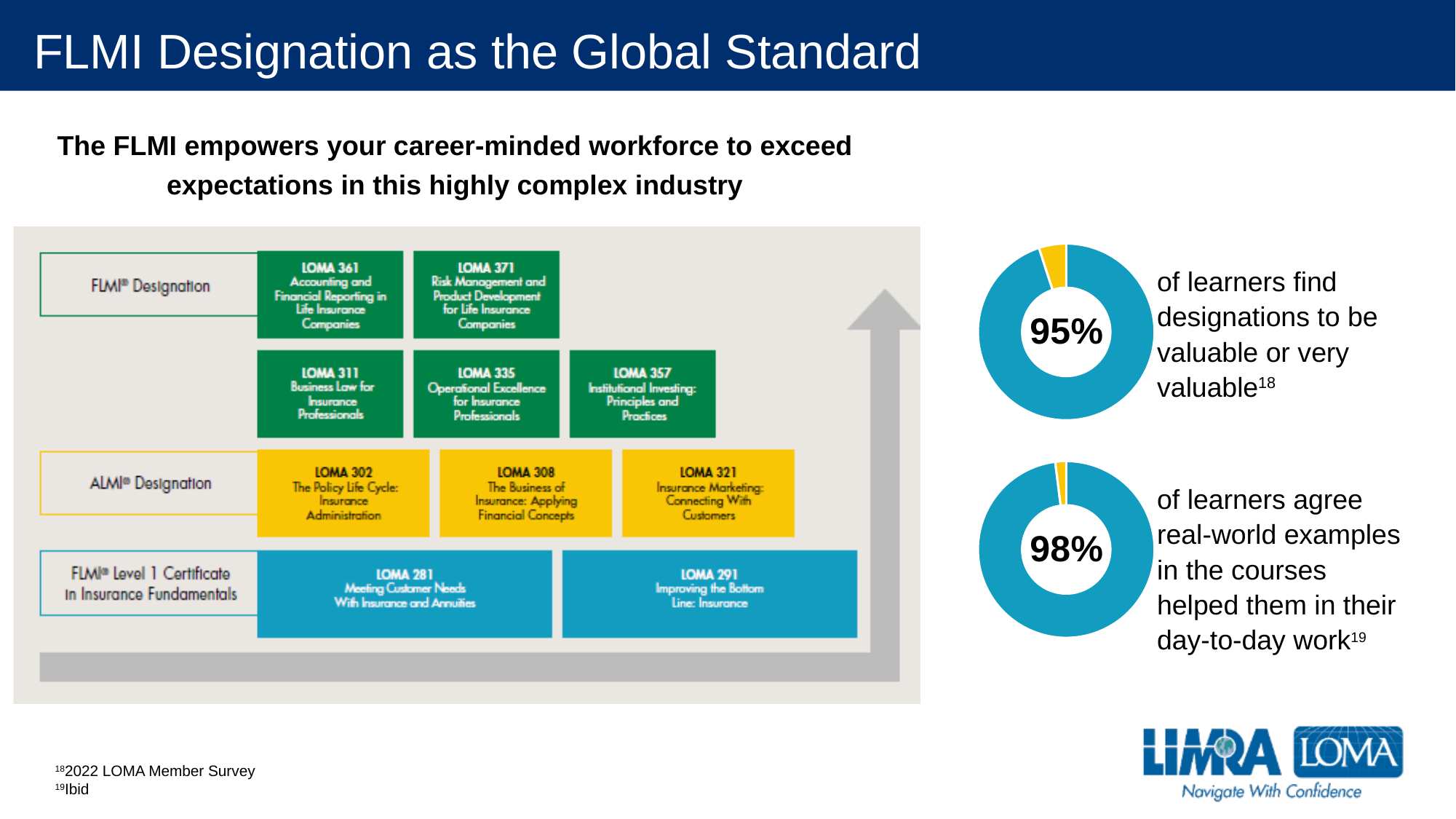
Which survey is cited as the source for the 95% figure in the upper donut chart? 2022 LOMA Member Survey Which is larger: the share of learners who find designations valuable or very valuable, or the share who agree real-world examples helped them in their day-to-day work? Real-world examples helped (98%) How many donut charts are shown on the right side of the slide? 2 In the upper donut chart on the right, what percentage of learners find designations to be valuable or very valuable? 95% In the lower donut chart on the right, what percentage of learners agree real-world examples in the courses helped them in their day-to-day work? 98% What colour is the small slice in each donut chart that represents the remaining learners? Yellow In the lower donut chart, what share of the ring is filled in blue? 98% What kind of chart is used to show the 95% and 98% figures on the right of the slide? Donut (pie) chart What is the difference in percentage points between the 98% figure in the lower donut chart and the 95% figure in the upper donut chart? 3 percentage points In the upper donut chart, what share of the ring is filled in blue? 95%